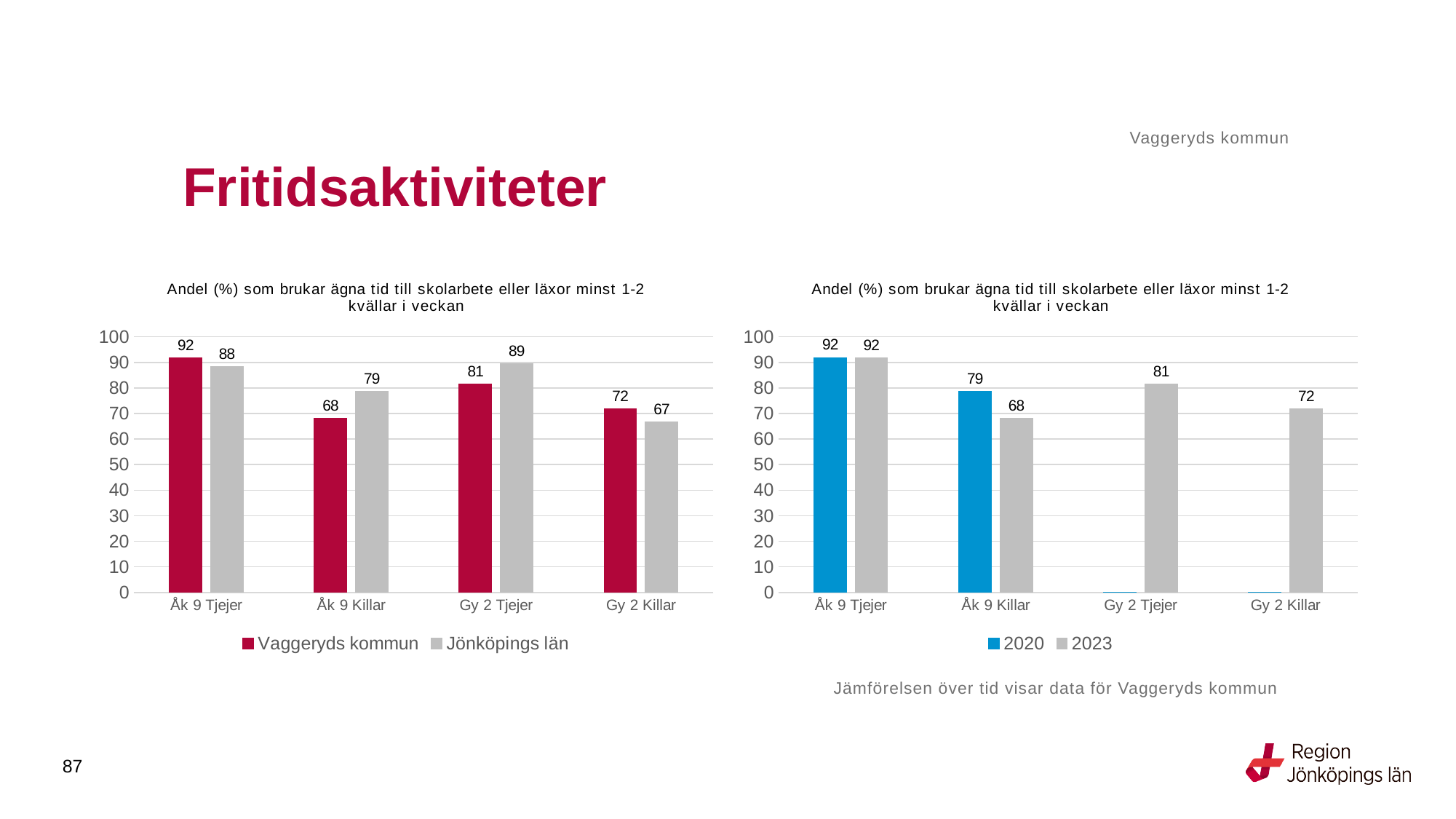
In the left chart, what is the value for Jönköpings län for Gy 2 Killar? 67 In the left chart, what is the value for Vaggeryds kommun for Åk 9 Tjejer? 92 In the left chart, what is the difference between Jönköpings län and Vaggeryds kommun for Åk 9 Killar? 11 What kind of chart is the right chart? Bar chart In the right chart, what is the value for 2023 for Gy 2 Tjejer? 81 In the right chart, how many series does the legend list? 2 In the left chart, how many categories are shown on the x axis? 4 In the left chart, which category has the lowest value for Vaggeryds kommun? Åk 9 Killar In the left chart, which is larger for Gy 2 Killar: Vaggeryds kommun or Jönköpings län? Vaggeryds kommun In the right chart, what is the difference between 2020 and 2023 for Åk 9 Killar? 11 In the right chart, what is the value for 2020 for Åk 9 Killar? 79 In the right chart, which category has the lowest value for 2023? Åk 9 Killar